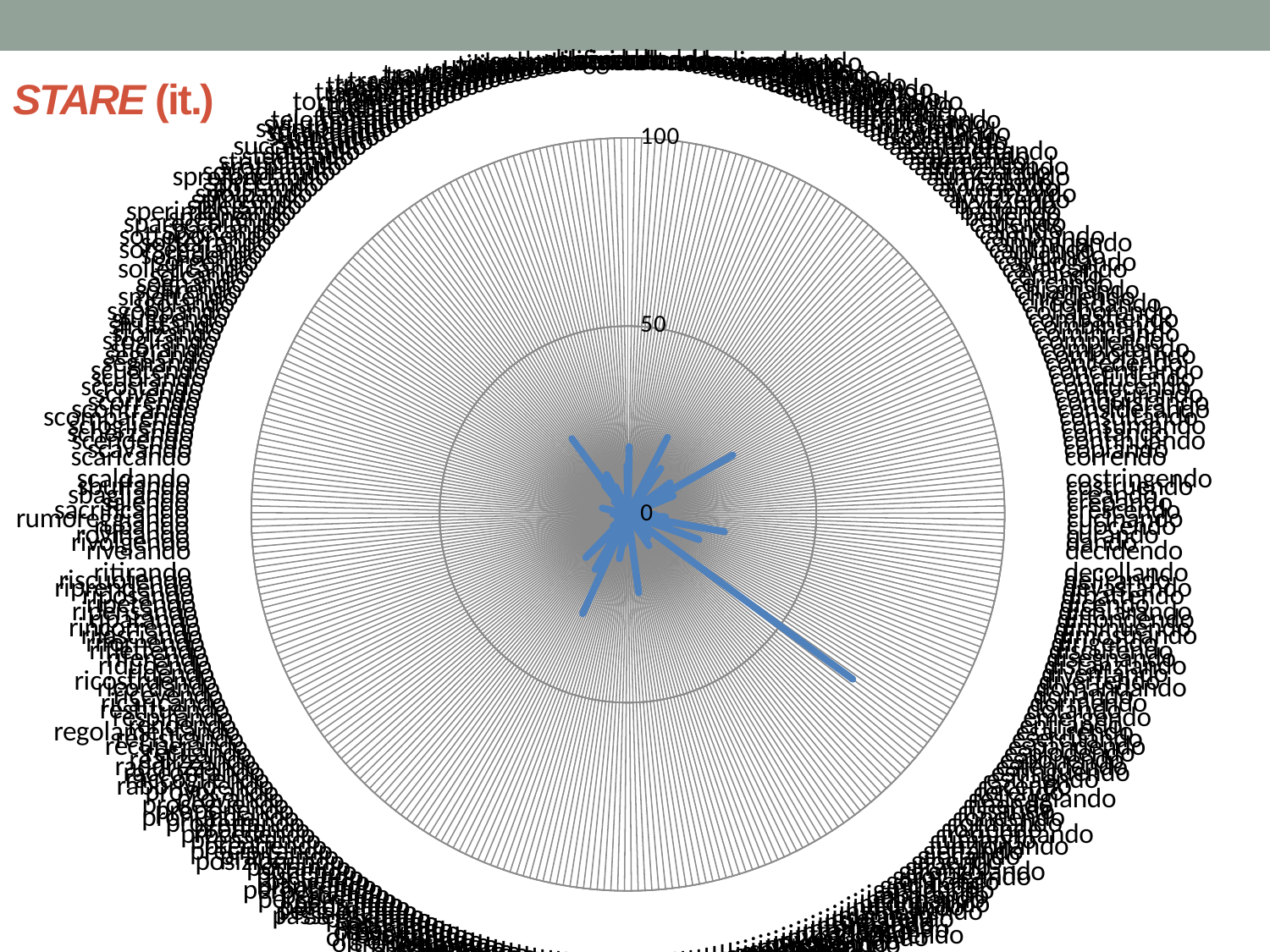
What kind of chart is shown on the slide? radar chart What is the maximum value shown on the chart's radial axis? 100 Is the longest spike on the radar chart greater or less than 50? greater What is the title shown at the top left of the slide? STARE (it.) What value is shown at the centre of the radar chart? 0 Is the longest spike on the radar chart greater or less than 100? less